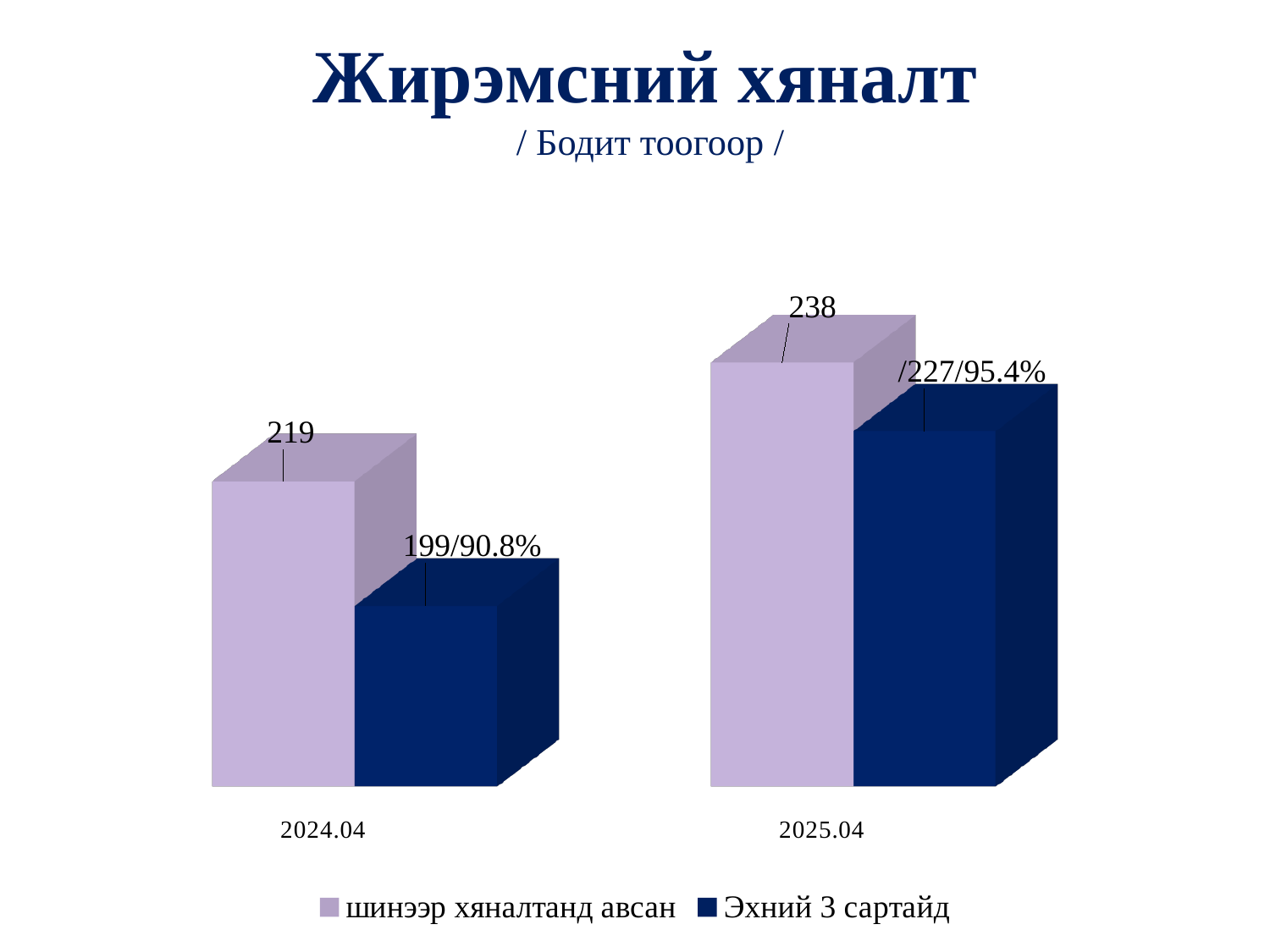
What data label is shown for 'Эхний 3 сартайд' in 2024.04? 199/90.8% What is the value for 'шинээр хяналтанд авсан' in 2025.04? 238 What is the difference between the 'шинээр хяналтанд авсан' values for 2025.04 and 2024.04? 19 How many categories are shown on the x axis? 2 What data label is shown for 'Эхний 3 сартайд' in 2025.04? /227/95.4% What is the title of the chart? Жирэмсний хяналт Is the 'шинээр хяналтанд авсан' value in 2024.04 larger or smaller than the 'Эхний 3 сартайд' value in the same year? larger How many series does the legend list? 2 What kind of chart is shown on the slide? bar chart Which year has the lower value for 'Эхний 3 сартайд'? 2024.04 Which year has the higher value for 'шинээр хяналтанд авсан'? 2025.04 What is the value for 'шинээр хяналтанд авсан' in 2024.04? 219